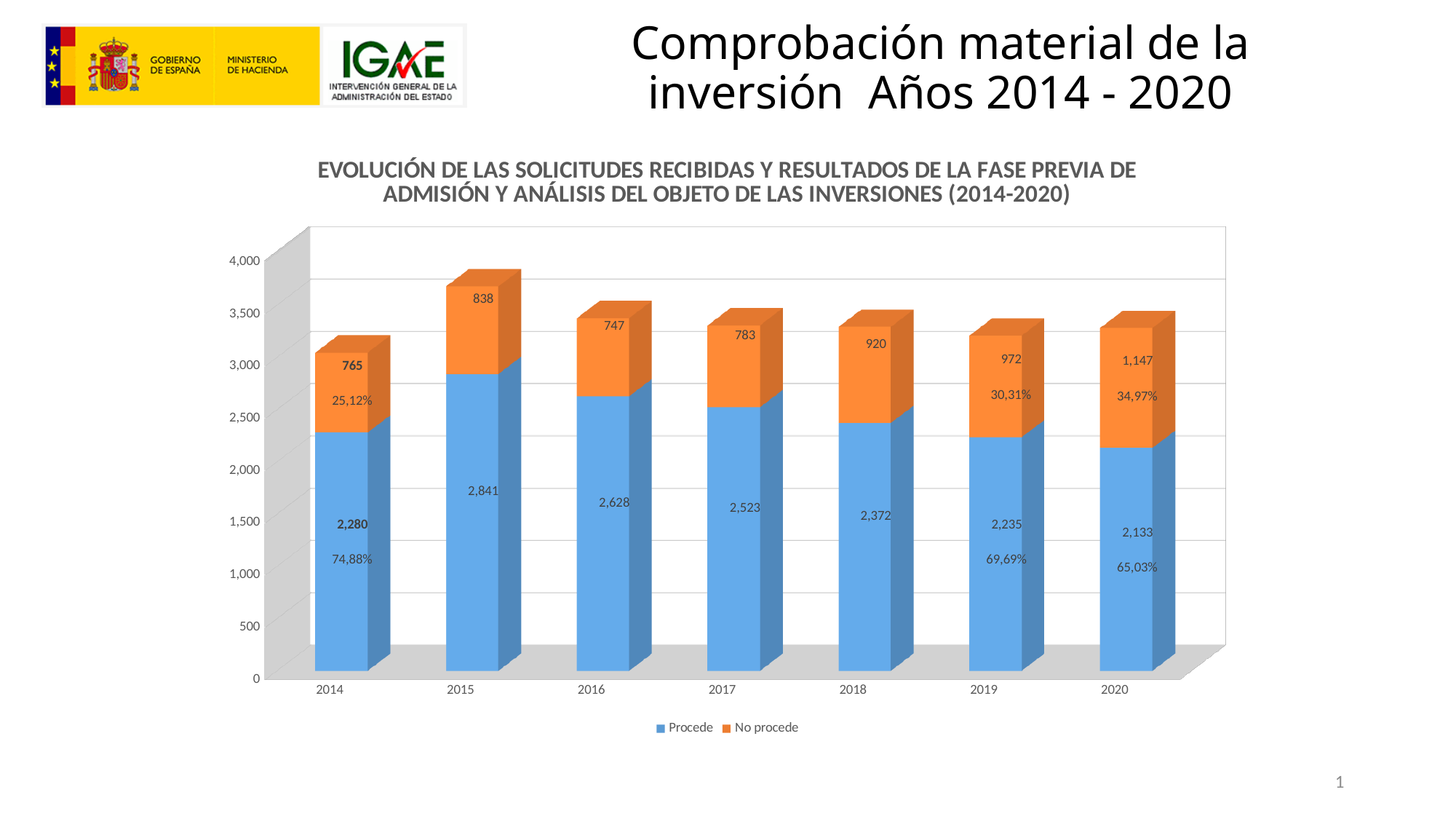
What is the value of Procede in 2015? 2,841 Which is larger, the No procede value in 2018 or in 2017? 2018 Which year has the lowest No procede value? 2016 What is the difference between the Procede values for 2016 and 2017? 105 Which year has the highest Procede value? 2015 What type of chart is shown on the slide? Stacked bar chart Does the Procede value rise or fall from 2015 to 2020? Fall What percentage is shown for No procede in 2019? 30,31% How many years are shown on the x axis? 7 How many series does the legend list? 2 What is the value of No procede in 2020? 1,147 What is the total of the stacked bar for 2014? 3,045